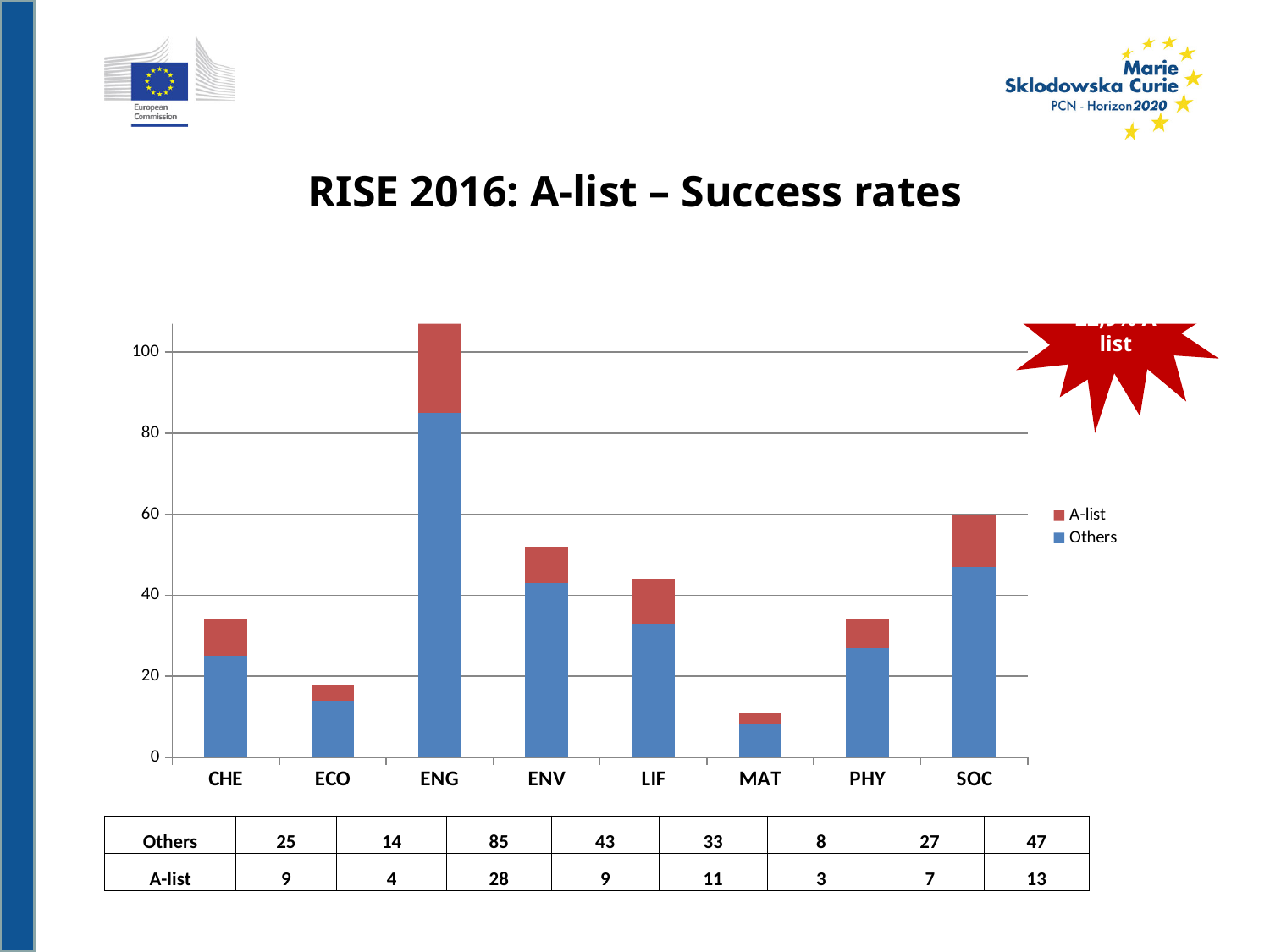
What is the Others value for ENG? 85 Which colour represents the A-list series in the legend? red How many categories are shown on the x axis? 8 What kind of chart is shown on the slide? stacked bar chart Which is larger, the A-list value for LIF or the A-list value for PHY? LIF How many series does the legend list? 2 Which category has the lowest A-list value? MAT What is the A-list value for SOC? 13 What is the difference between the Others values for ENV and LIF? 10 What is the total of the stacked bar for ENG? 113 Is the total stacked bar for SOC greater or less than 40? greater Which category has the highest Others value? ENG